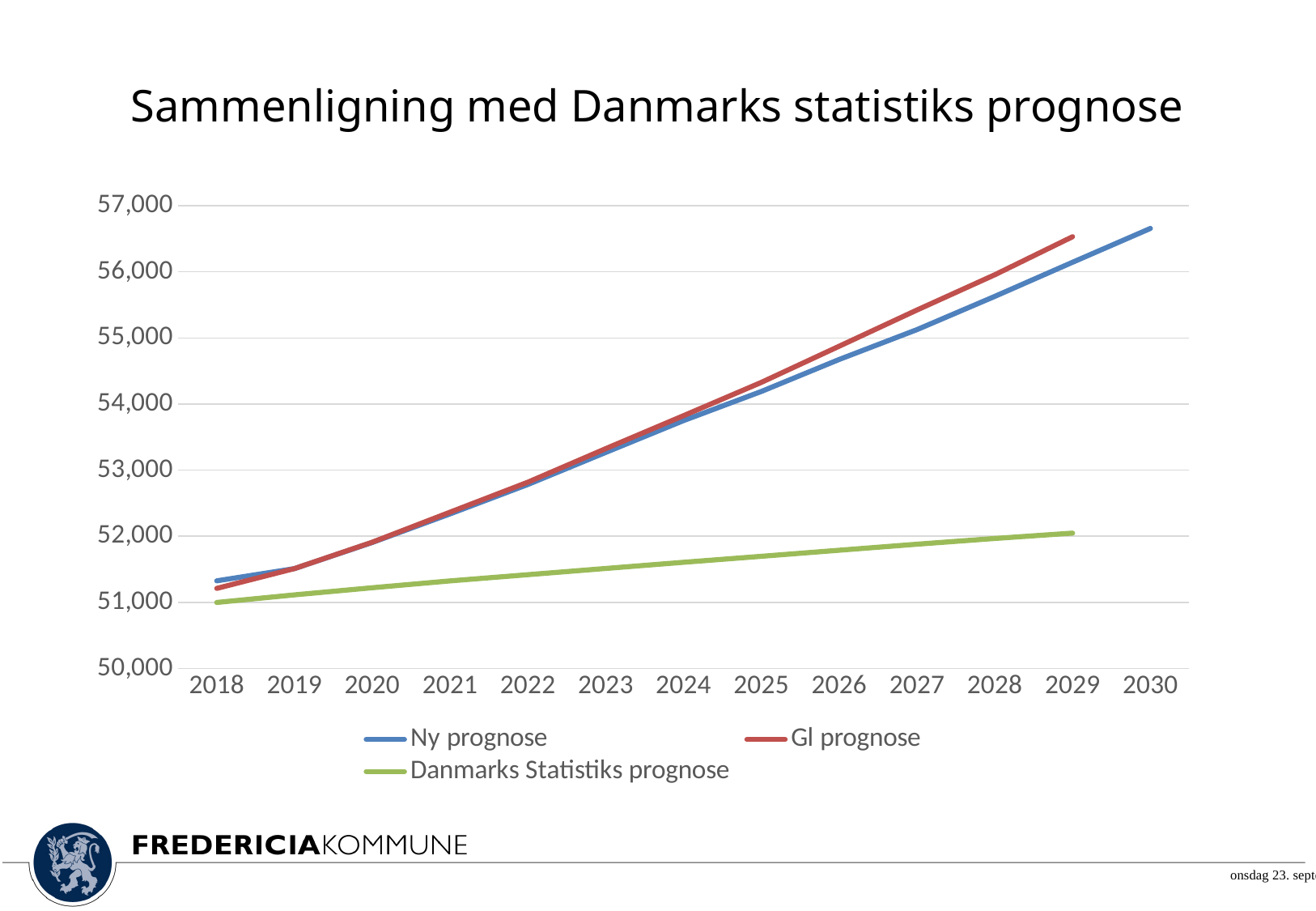
Which series is drawn in green? Danmarks Statistiks prognose In 2029, which is higher: Gl prognose or Danmarks Statistiks prognose? Gl prognose Is the value for Gl prognose in 2029 greater or less than 56,000? greater Is the value for Ny prognose in 2022 greater or less than 53,000? less Is the value for Danmarks Statistiks prognose in 2025 greater or less than 52,000? less What is the title of the chart? Sammenligning med Danmarks statistiks prognose What kind of chart is shown on the slide? Line chart How many years are shown on the x axis? 13 How many series does the legend list? 3 Does the Ny prognose series rise or fall from 2018 to 2030? Rise Which series has the lowest value in 2029? Danmarks Statistiks prognose